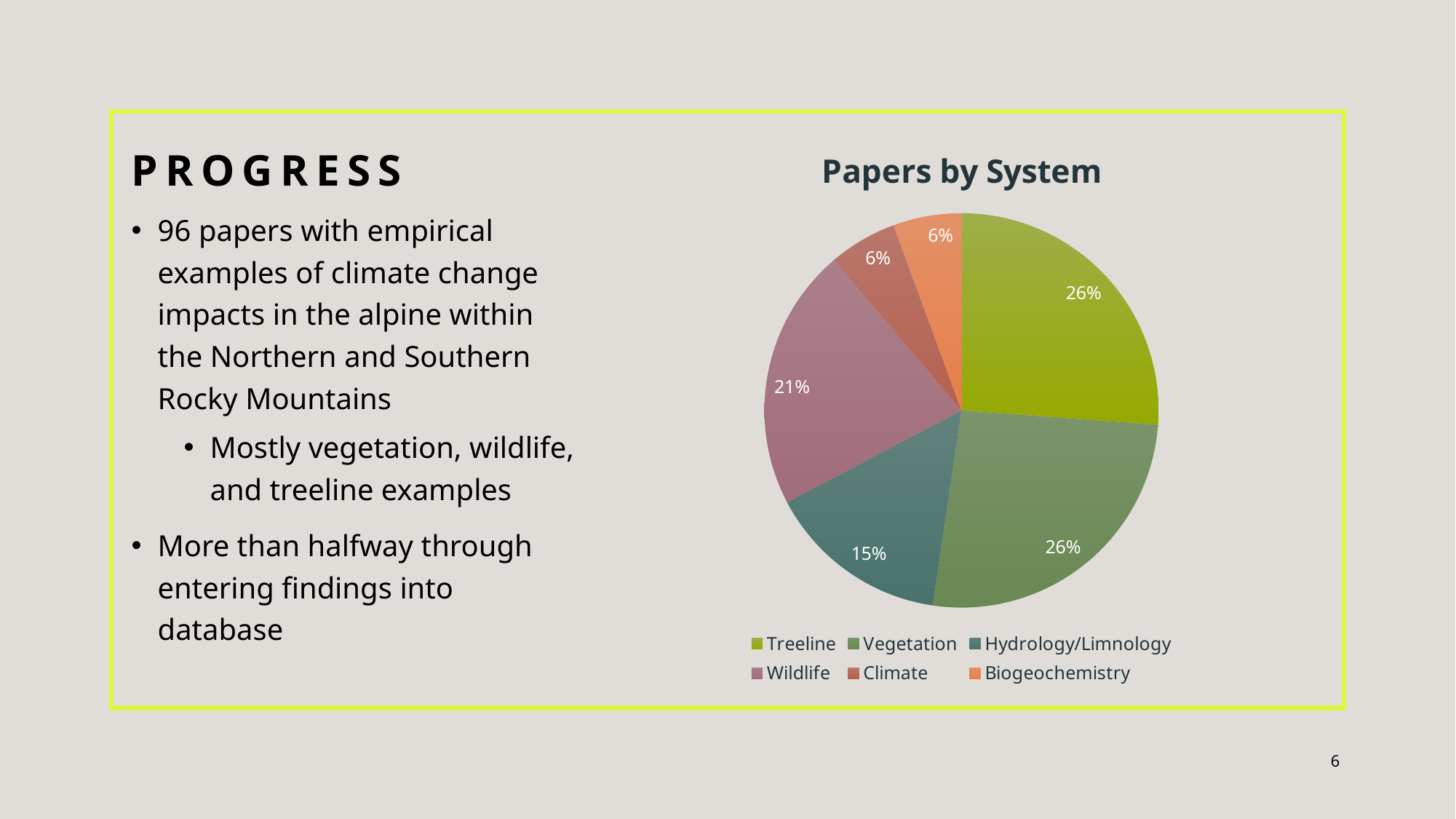
What share of papers does the Hydrology/Limnology slice represent? 15% What is the title of the chart? Papers by System What share of papers does the Vegetation slice represent? 26% What share of papers does the Climate slice represent? 6% What share of papers does the Wildlife slice represent? 21% How many categories (slices) does the pie chart have? 6 What kind of chart is shown on the slide? pie chart Which slice is larger, Treeline or Climate? Treeline What share of papers does the Treeline slice represent? 26% What is the difference in percentage points between the Wildlife slice and the Hydrology/Limnology slice? 6% Which slice is larger, Wildlife or Hydrology/Limnology? Wildlife What share of papers does the Biogeochemistry slice represent? 6%